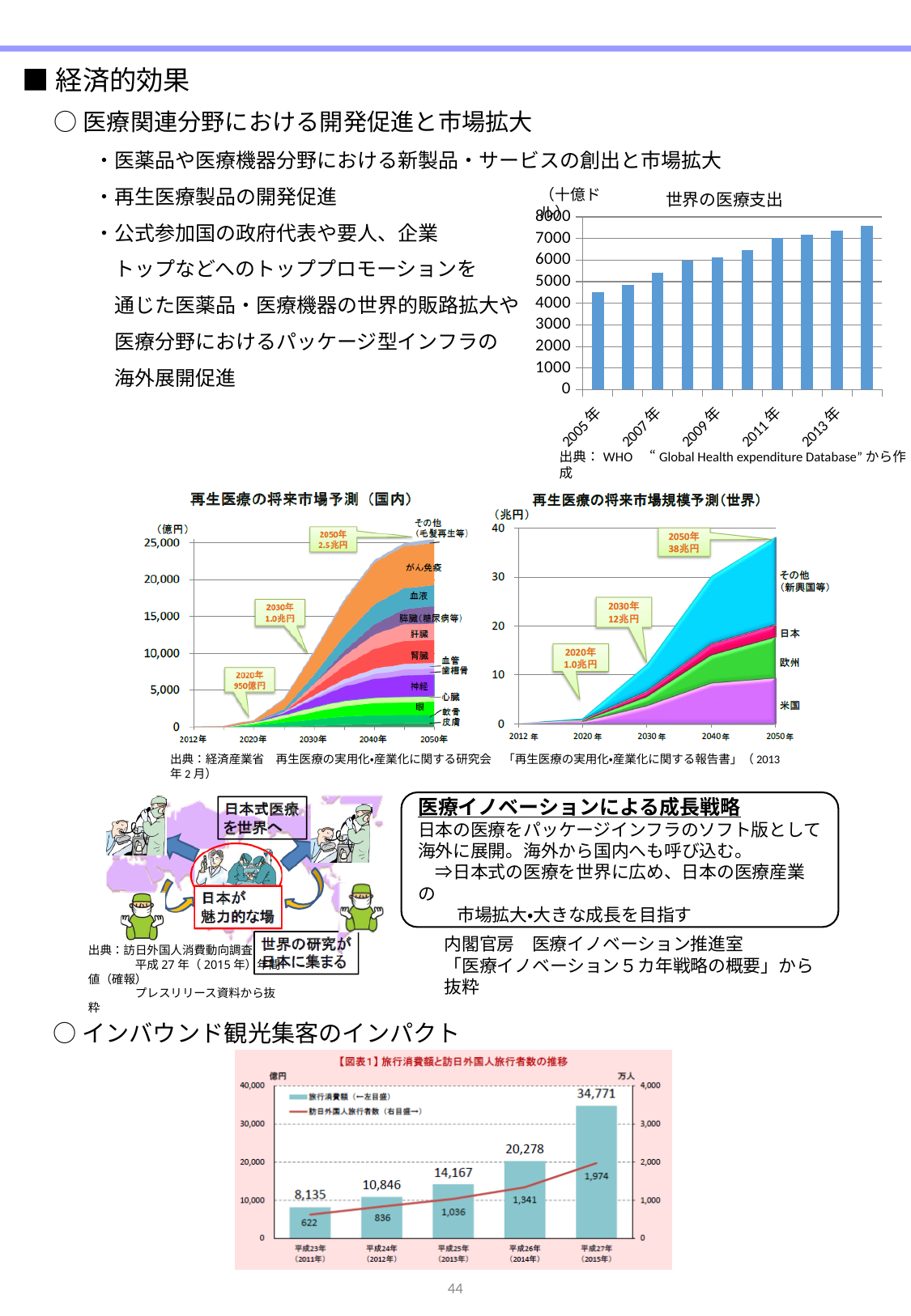
In the 「旅行消費額と訪日外国人旅行者数の推移」 chart, what is the 旅行消費額 for 平成27年（2015年）? 34,771 In the 「世界の医療支出」 chart, is the value for 2005年 greater or less than 5000? less In the 「再生医療の将来市場予測（国内）」 chart, what market size is shown in the callout for 2020年? 950億円 In the 「再生医療の将来市場予測（国内）」 chart, what market size is shown in the callout for 2050年? 2.5兆円 In the 「世界の医療支出」 chart, do the values rise or fall from 2005年 to the last year shown? rise In the 「旅行消費額と訪日外国人旅行者数の推移」 chart, what is the difference in 旅行消費額 between 平成27年（2015年） and 平成26年（2014年）? 14,493 In the 「再生医療の将来市場規模予測(世界)」 chart, what market size is shown in the callout for 2050年? 38兆円 In the 「旅行消費額と訪日外国人旅行者数の推移」 chart, what is the 訪日外国人旅行者数 for 平成23年（2011年）? 622 In the 「世界の医療支出」 chart, is the value for 2013年 greater or less than 7000? greater In the 「再生医療の将来市場規模予測(世界)」 chart, what market size is shown in the callout for 2030年? 12兆円 In the 「世界の医療支出」 chart, what kind of chart is it? bar chart In the 「世界の医療支出」 chart, how many bars are plotted? 10